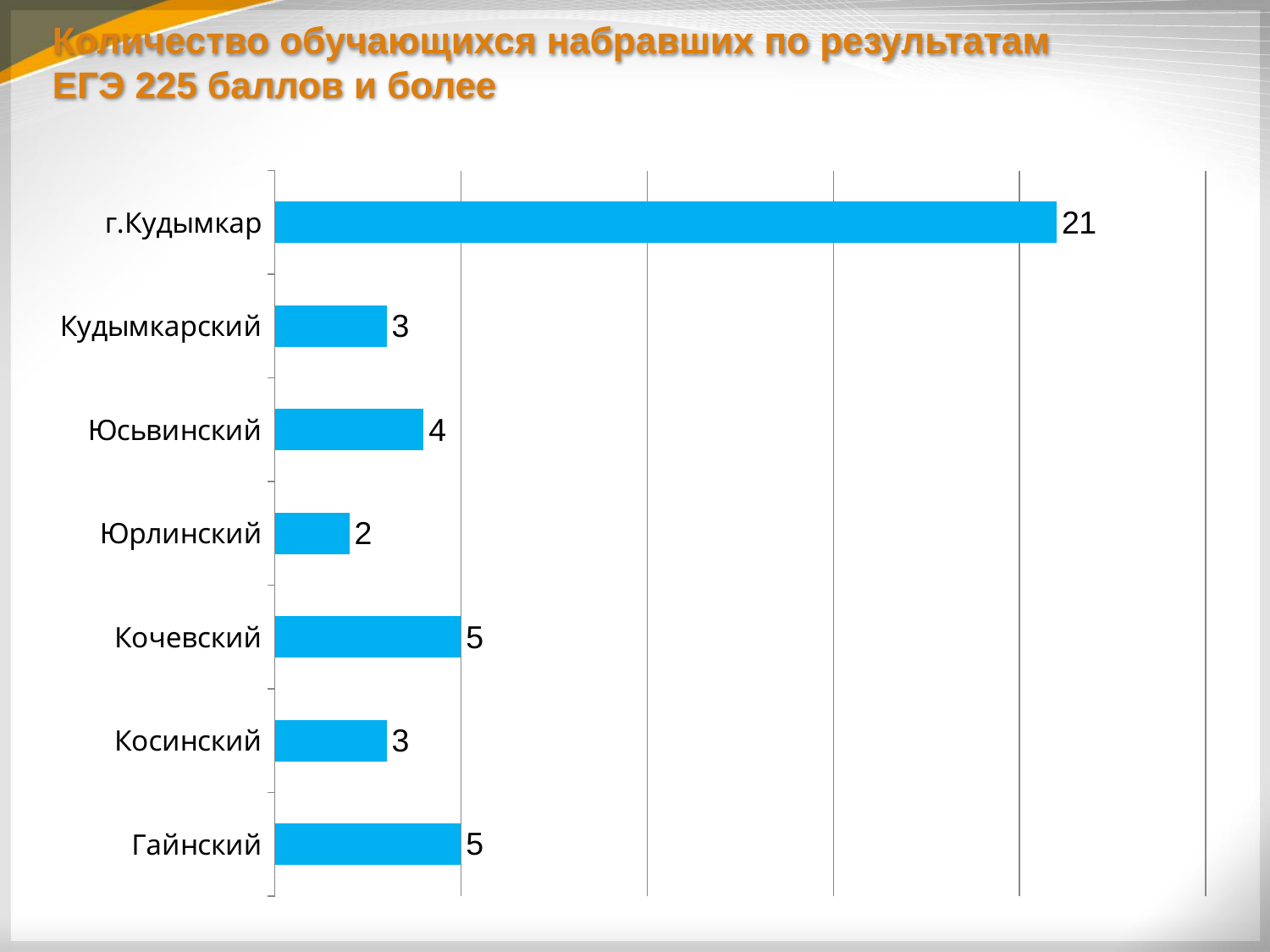
What is the value for Юрлинский? 2 Which category has the highest value? г.Кудымкар What is the value for Кочевский? 5 Which is larger, the value for Кудымкарский or the value for Кочевский? Кочевский What is the value for г.Кудымкар? 21 What is the difference between the values for г.Кудымкар and Гайнский? 16 How many categories are shown in the chart? 7 What is the value for Юсьвинский? 4 Which category has the lowest value? Юрлинский What is the difference between the values for Юсьвинский and Юрлинский? 2 What kind of chart is shown on the slide? bar chart What is the title of the slide? Количество обучающихся набравших по результатам ЕГЭ 225 баллов и более